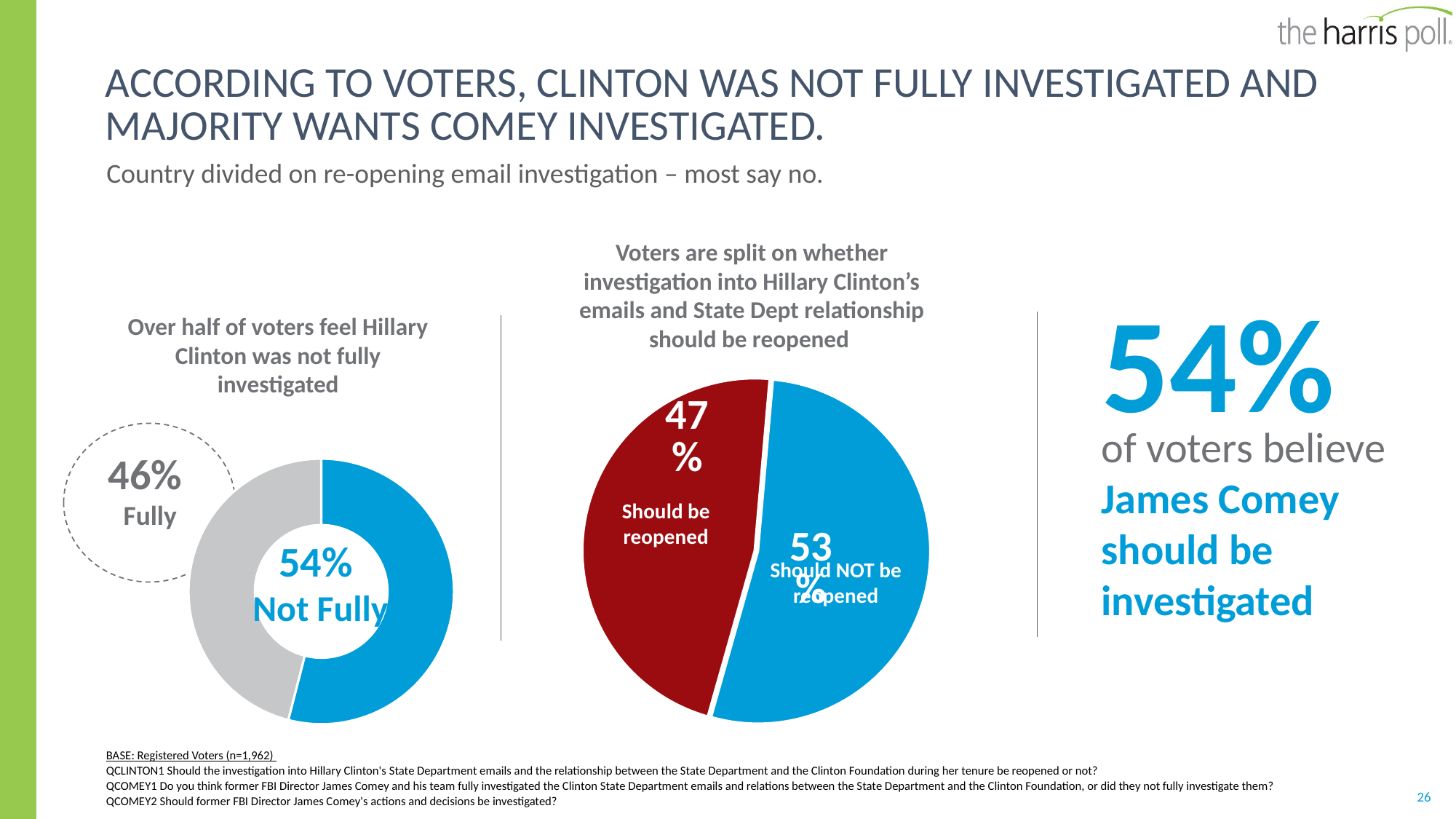
In the left chart about whether Hillary Clinton was fully investigated, what share of voters say 'Fully'? 46% In the middle chart about reopening the investigation, what share of voters say it should be reopened? 47% In the left chart about whether Hillary Clinton was fully investigated, what share of voters say 'Not Fully'? 54% In the left chart about whether Hillary Clinton was fully investigated, which response has the larger share? Not Fully What kind of chart is the left chart about whether Hillary Clinton was fully investigated? Donut chart In the middle chart about reopening the investigation, what is the difference in percentage points between 'Should NOT be reopened' and 'Should be reopened'? 6 In the middle chart about reopening the investigation, what colour is the 'Should be reopened' slice? Dark red In the middle chart about reopening the investigation, what share of voters say it should NOT be reopened? 53% In the middle chart about reopening the investigation, is the share for 'Should be reopened' larger or smaller than the share for 'Should NOT be reopened'? Smaller In the left chart about whether Hillary Clinton was fully investigated, what is the difference in percentage points between 'Not Fully' and 'Fully'? 8 In the middle chart about reopening the investigation, which response has the smaller share? Should be reopened How many slices does the middle pie chart about reopening the investigation have? 2